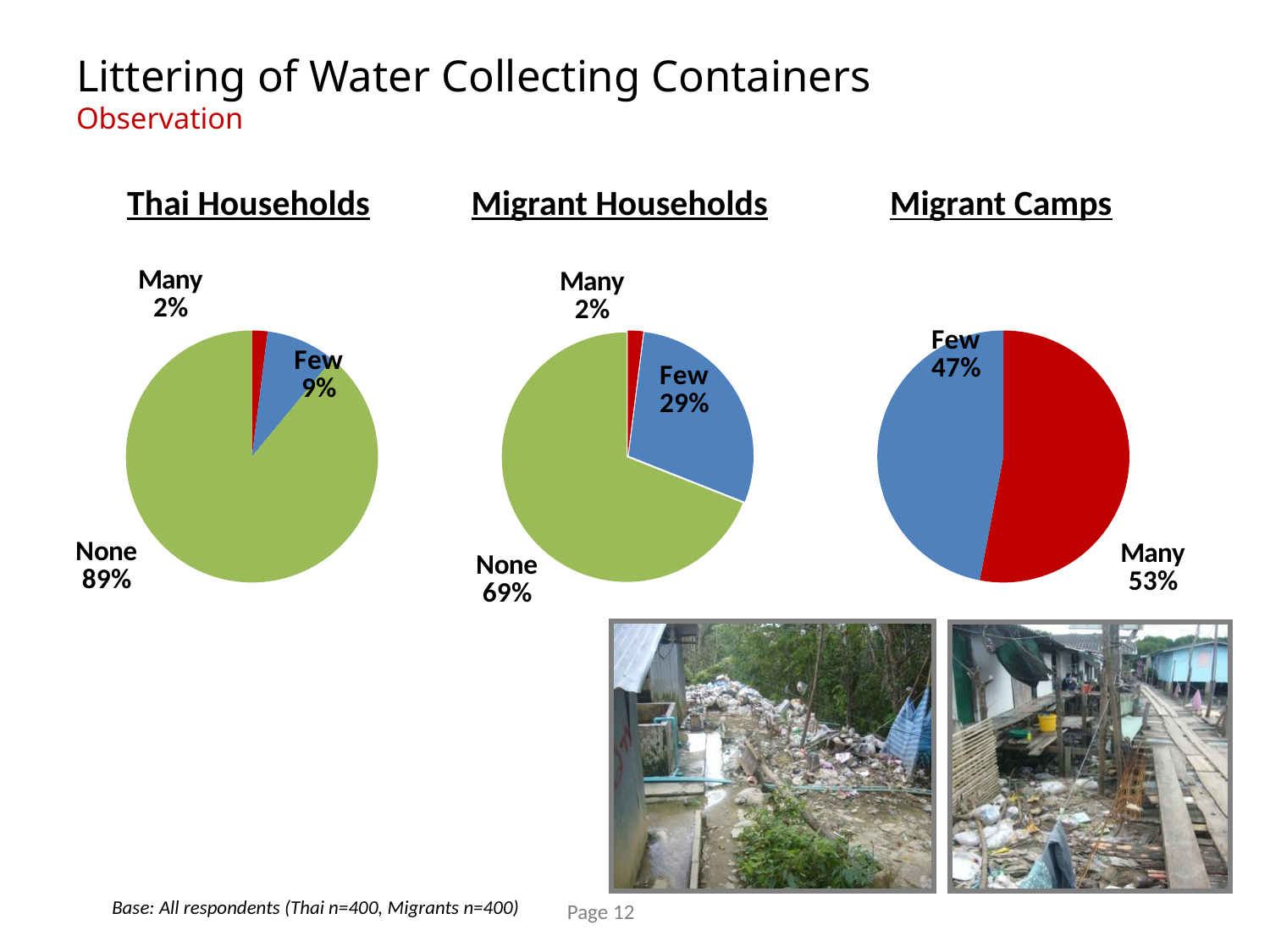
In the Migrant Households chart, what percentage is labelled Few? 29% In the Migrant Households chart, what is the combined share of Few and Many? 31% How many slices does the Migrant Households chart have? 3 In the Migrant Camps chart, what percentage is labelled Many? 53% Which is larger: the Few share in the Migrant Households chart or the Few share in the Thai Households chart? Migrant Households How many slices does the Migrant Camps chart have? 2 In the Migrant Camps chart, which category has the largest share? Many What type of chart is the Thai Households chart? Pie chart In the Thai Households chart, which category has the smallest share? Many In the Migrant Camps chart, what colour is the Few slice? Blue What is the difference between the None share in the Thai Households chart and the None share in the Migrant Households chart? 20% In the Thai Households chart, what percentage is labelled None? 89%